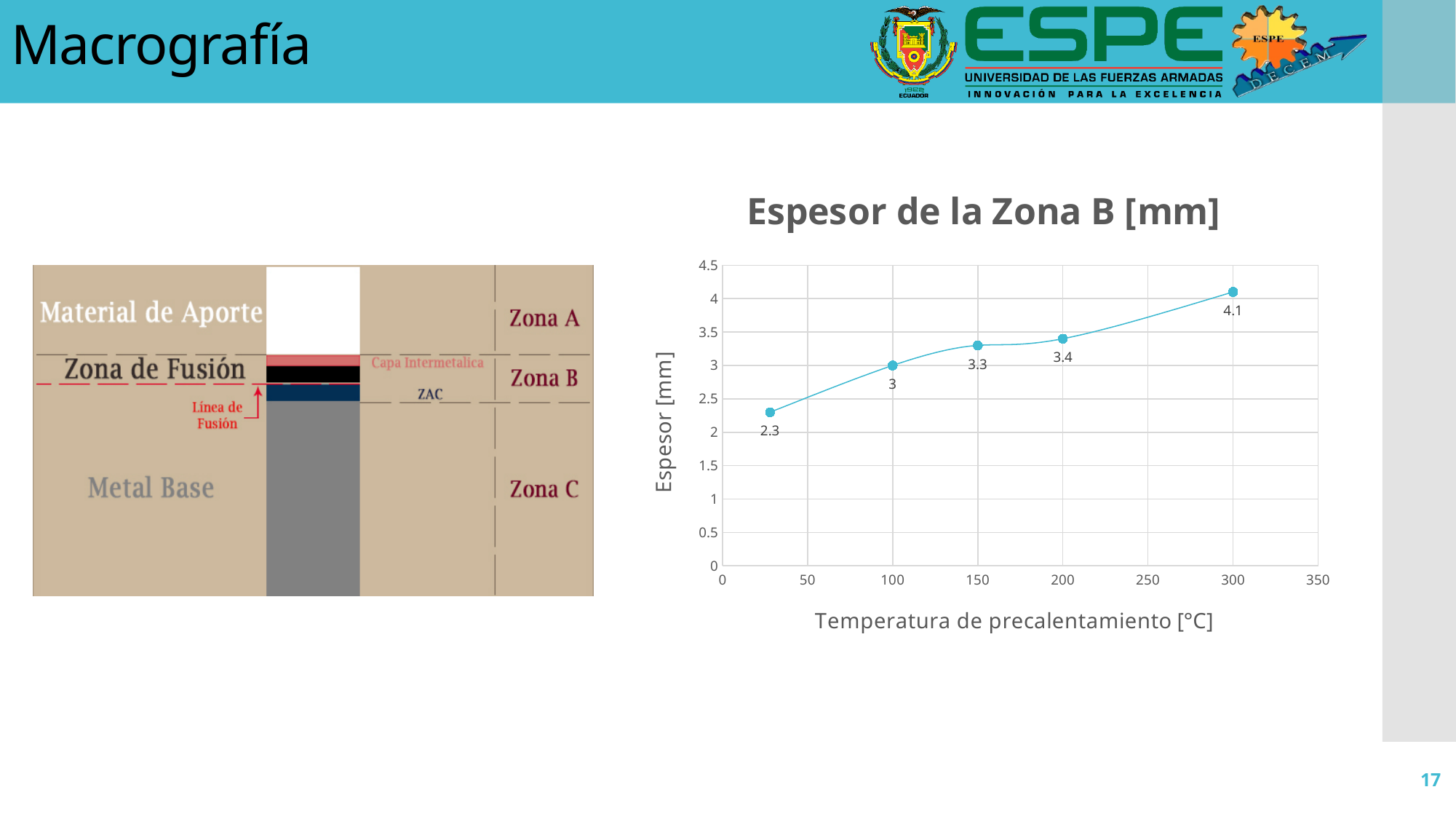
What is the Zona B thickness at a preheating temperature of 300 °C? 4.1 What is the Zona B thickness at a preheating temperature of 200 °C? 3.4 What is the Zona B thickness at a preheating temperature of 100 °C? 3 What is the Zona B thickness at a preheating temperature of 150 °C? 3.3 Which preheating temperature gives a larger thickness, 150 °C or 200 °C? 200 °C What is the highest thickness value plotted on the chart? 4.1 What is the lowest thickness value plotted on the chart? 2.3 What kind of chart is shown on the slide? line chart How many data points are plotted on the chart? 5 What is the difference in thickness between the points at 300 °C and 100 °C? 1.1 Is the thickness of the first (leftmost) data point greater or less than 2.5? less Does the thickness rise or fall as the preheating temperature increases? rises